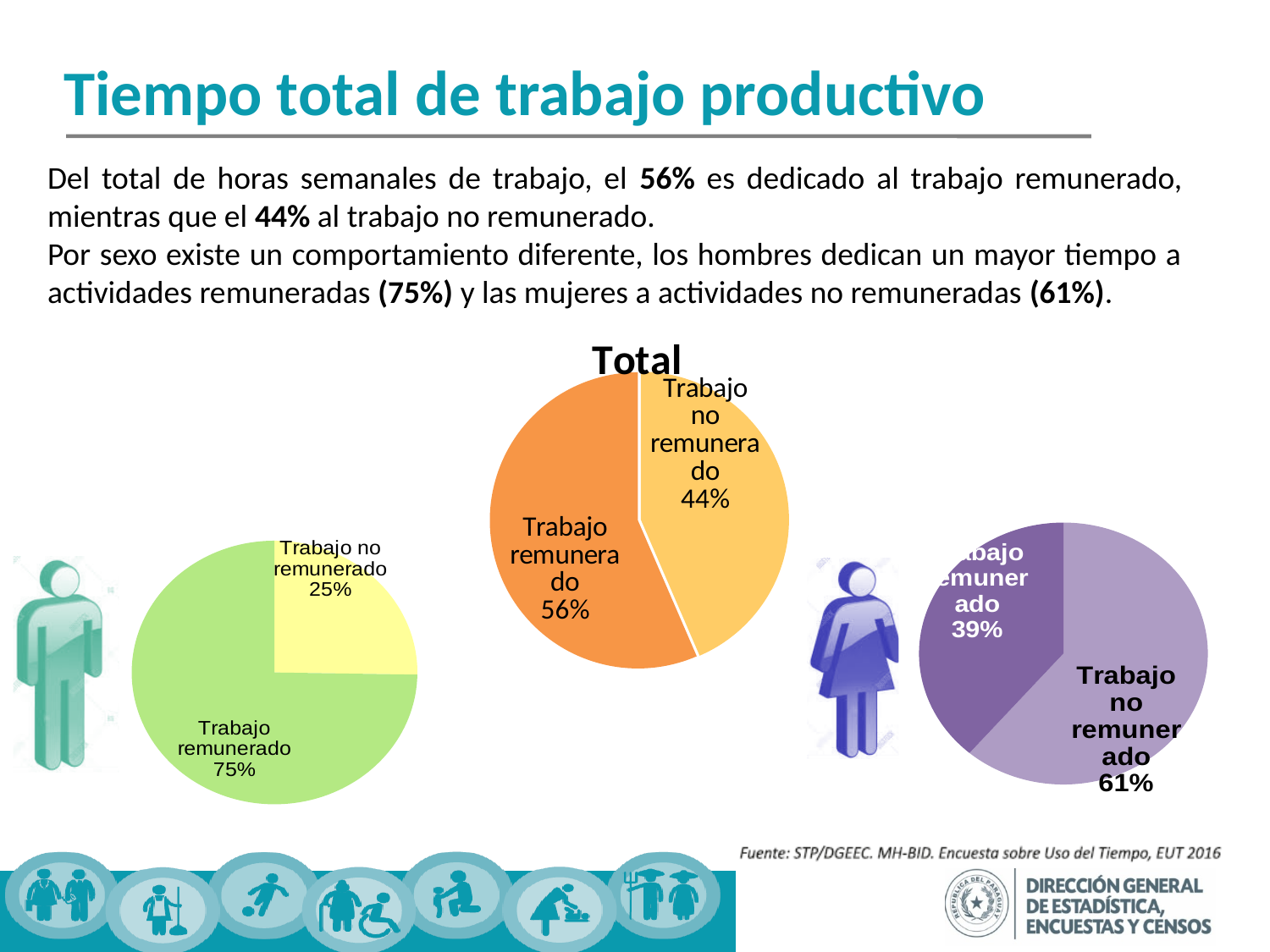
How many slices does the pie chart titled "Total" have? 2 In the purple pie chart on the right of the slide, which slice is the largest? Trabajo no remunerado In the green pie chart on the left of the slide, what share is labelled for "Trabajo remunerado"? 75% In the pie chart titled "Total", what share is labelled for "Trabajo no remunerado"? 44% In the pie chart titled "Total", what share is labelled for "Trabajo remunerado"? 56% In the pie chart titled "Total", what is the difference in percentage points between "Trabajo remunerado" and "Trabajo no remunerado"? 12 In the purple pie chart on the right of the slide, what share is labelled for "Trabajo no remunerado"? 61% What type of chart is the chart titled "Total"? Pie chart In the green pie chart on the left of the slide, what is the difference in percentage points between "Trabajo remunerado" and "Trabajo no remunerado"? 50 In the green pie chart on the left of the slide, which slice is the smallest? Trabajo no remunerado Which is larger: the "Trabajo remunerado" share in the green pie chart on the left or the "Trabajo remunerado" share in the pie chart titled "Total"? The green pie chart on the left In the green pie chart on the left of the slide, what share is labelled for "Trabajo no remunerado"? 25%